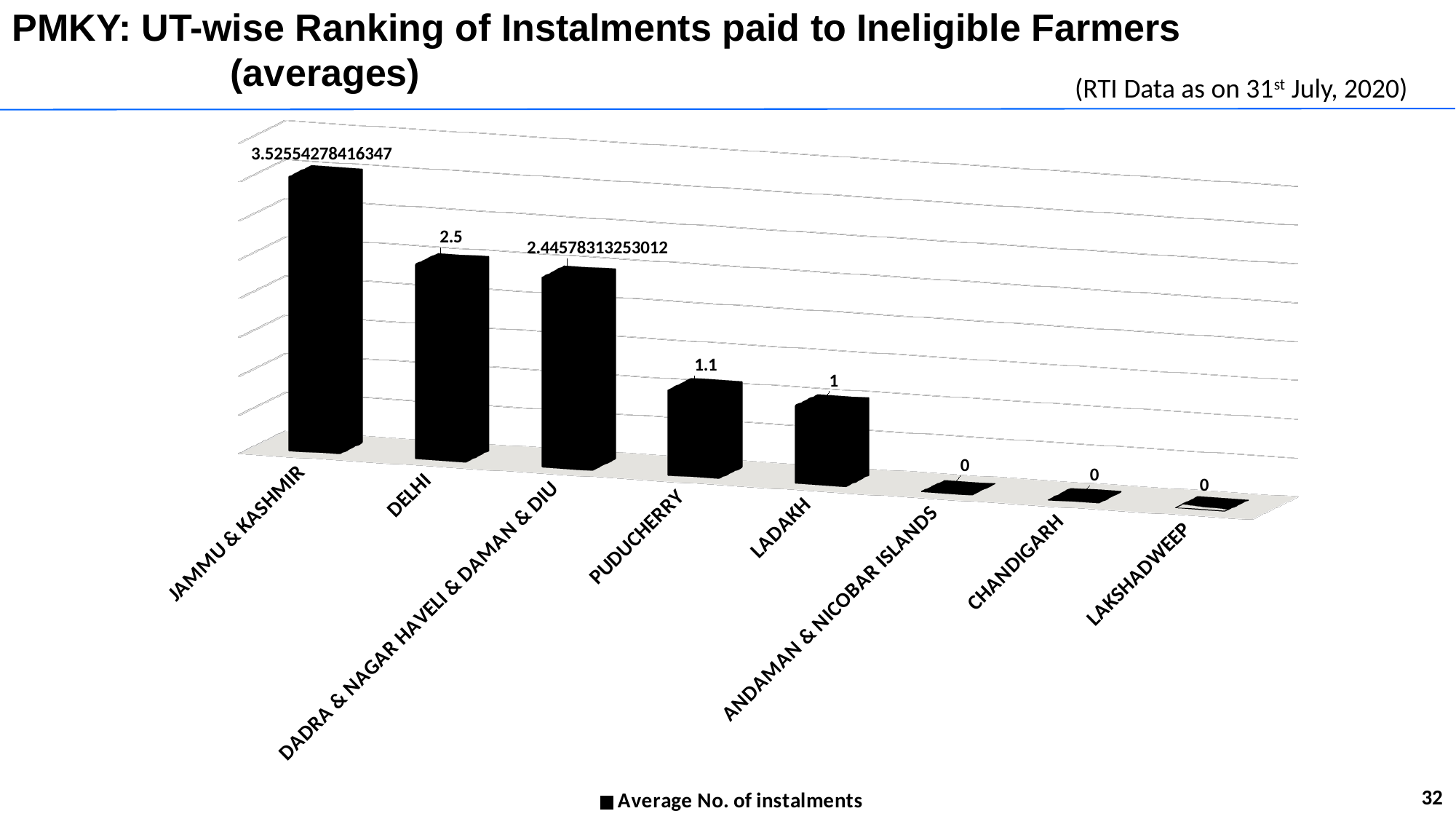
What is the average number of instalments for Chandigarh? 0 How many UTs are shown on the chart? 8 Which UT has the highest average number of instalments? Jammu & Kashmir What is the average number of instalments for Delhi? 2.5 What is the average number of instalments for Jammu & Kashmir? 3.52554278416347 What is the average number of instalments for Puducherry? 1.1 What is the average number of instalments for Ladakh? 1 What is the difference between the values for Delhi and Puducherry? 1.4 Which has a larger value, Puducherry or Ladakh? Puducherry What kind of chart is shown on the slide? Bar chart What is the legend entry shown below the chart? Average No. of instalments What is the average number of instalments for Dadra & Nagar Haveli & Daman & Diu? 2.44578313253012